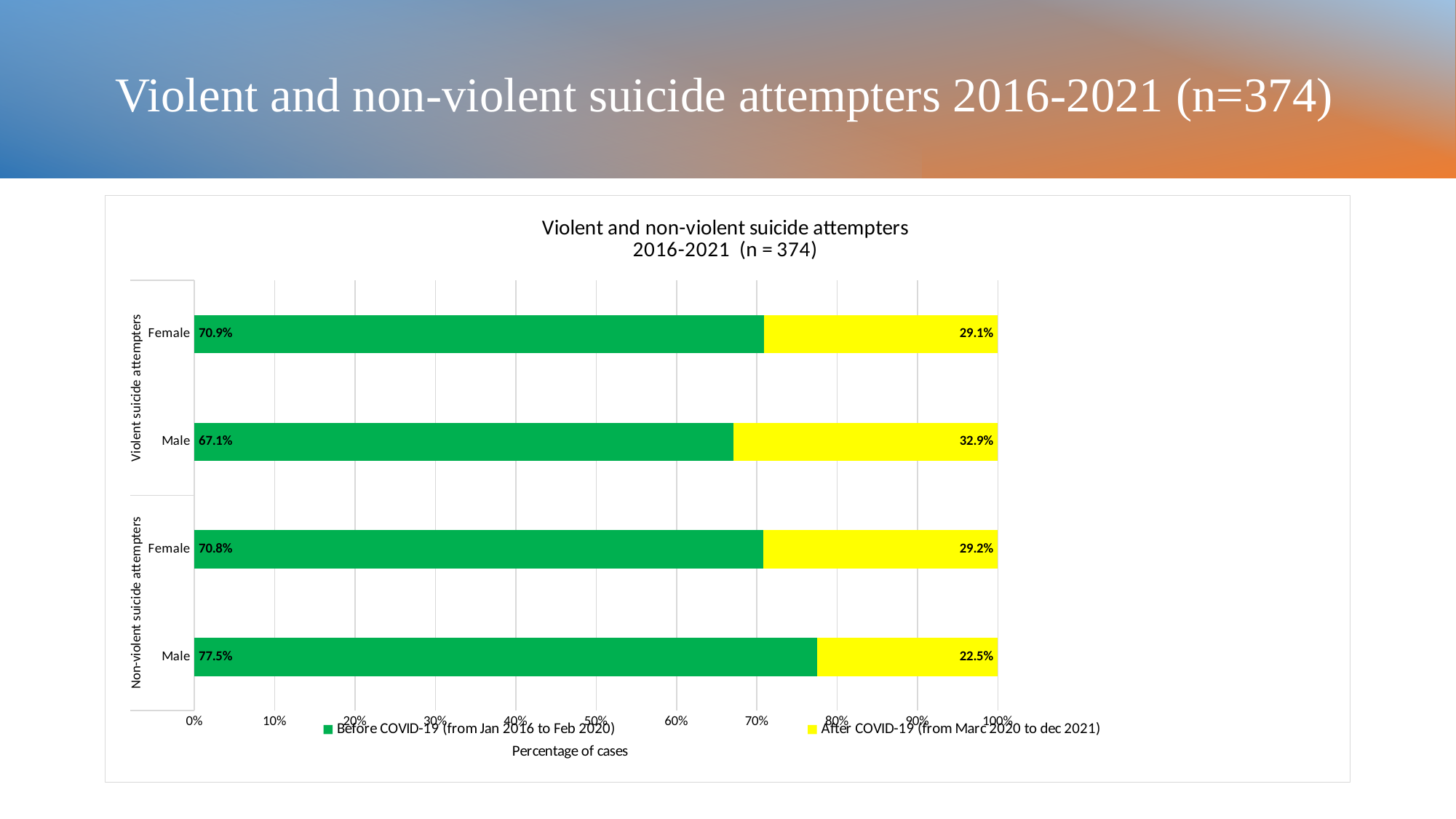
What kind of chart is shown on the slide? Stacked bar chart How many bars (groups) are plotted in the chart? 4 What is the total of the stacked bar for Male violent suicide attempters? 100% What is the Before COVID-19 value for Female violent suicide attempters? 70.9% What is the Before COVID-19 value for Male non-violent suicide attempters? 77.5% Which group has the highest Before COVID-19 percentage? Male non-violent suicide attempters How many series does the legend list? 2 What is the After COVID-19 value for Male violent suicide attempters? 32.9% What is the difference between the Before COVID-19 values for Male non-violent and Male violent suicide attempters? 10.4% Which group has the lowest After COVID-19 percentage? Male non-violent suicide attempters Which is larger: the After COVID-19 value for Male violent attempters or for Female violent attempters? Male violent attempters What is the After COVID-19 value for Female non-violent suicide attempters? 29.2%